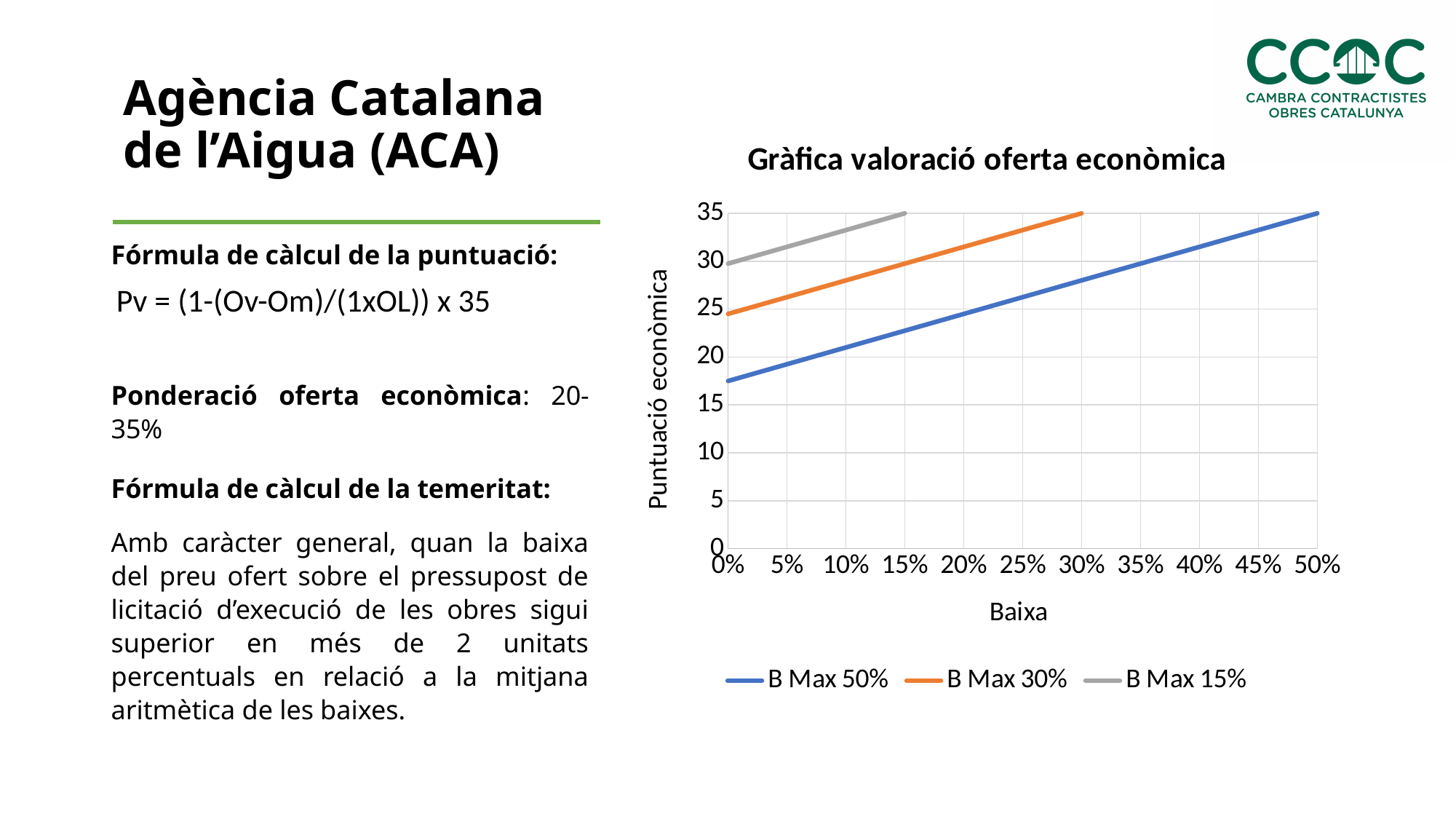
At a Baixa of 0%, which series has the higher Puntuació econòmica, B Max 50% or B Max 30%? B Max 30% What Puntuació econòmica does the B Max 50% series reach at a Baixa of 50%? 35 What Puntuació econòmica does the B Max 30% series reach at a Baixa of 30%? 35 What is the title of the chart? Gràfica valoració oferta econòmica What kind of chart is shown on the slide? line chart Is the value of the B Max 15% series at a Baixa of 0% greater or less than 25? greater How many series does the legend of the chart list? 3 At what Baixa does the B Max 15% series end? 15% Do the values of the B Max 50% series rise or fall as Baixa increases? rise Which series has the lowest Puntuació econòmica at a Baixa of 10%? B Max 50% Is the value of the B Max 50% series at a Baixa of 0% greater or less than 20? less What is the label of the vertical axis of the chart? Puntuació econòmica